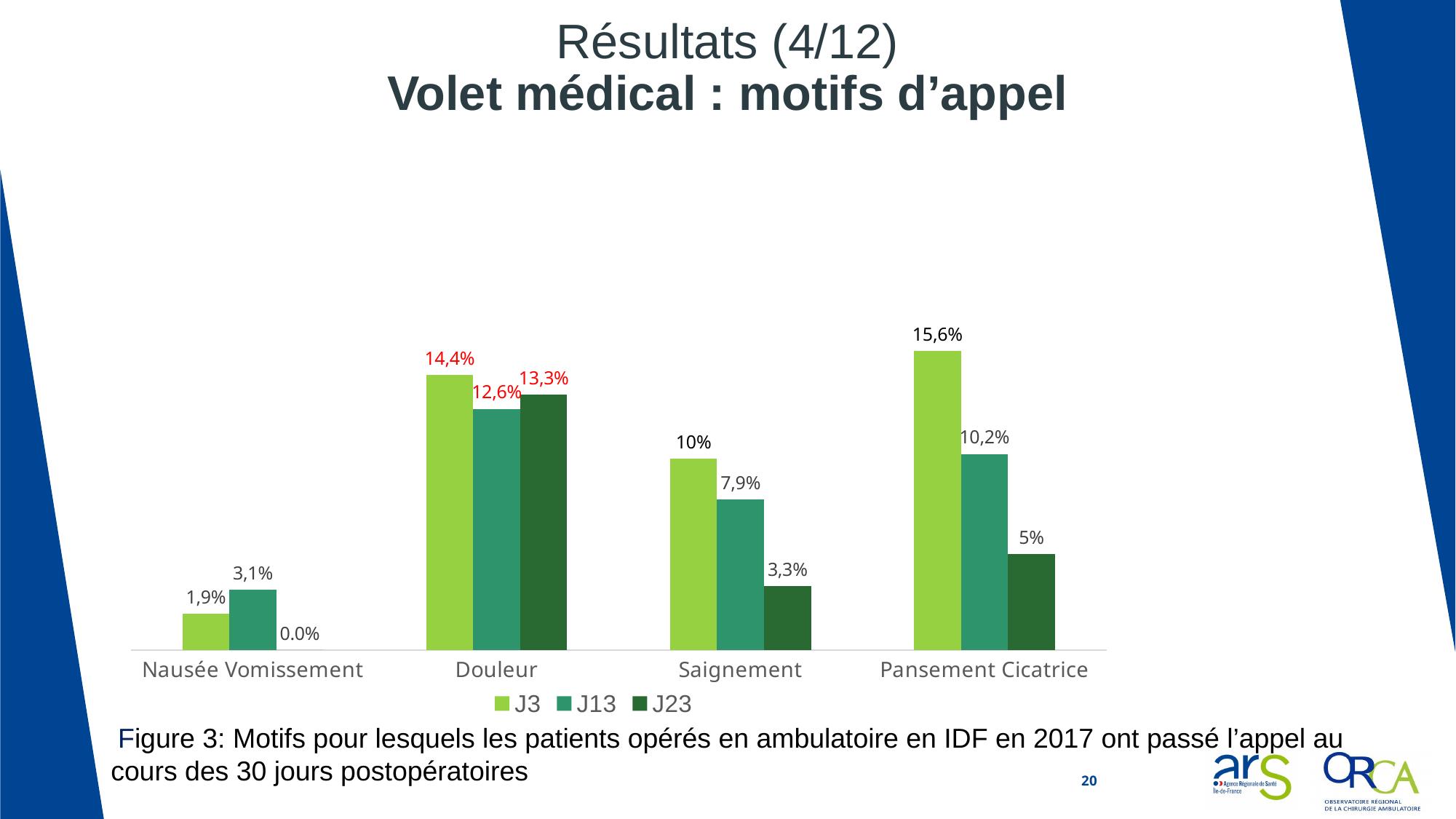
What is the J13 value for Saignement? 7,9% How many categories are shown on the x axis? 4 How many series does the legend list? 3 What is the J3 value for Douleur? 14,4% Which category has the highest J3 value? Pansement Cicatrice What is the difference between the J3 and J23 values for Saignement? 6,7% What is the J23 value for Pansement Cicatrice? 5% Which is larger for Douleur: the J13 value or the J23 value? J23 What is the difference between the J3 and J13 values for Pansement Cicatrice? 5,4% What is the J23 value for Nausée Vomissement? 0.0% Which category has the lowest J13 value? Nausée Vomissement What kind of chart is shown on the slide? Bar chart